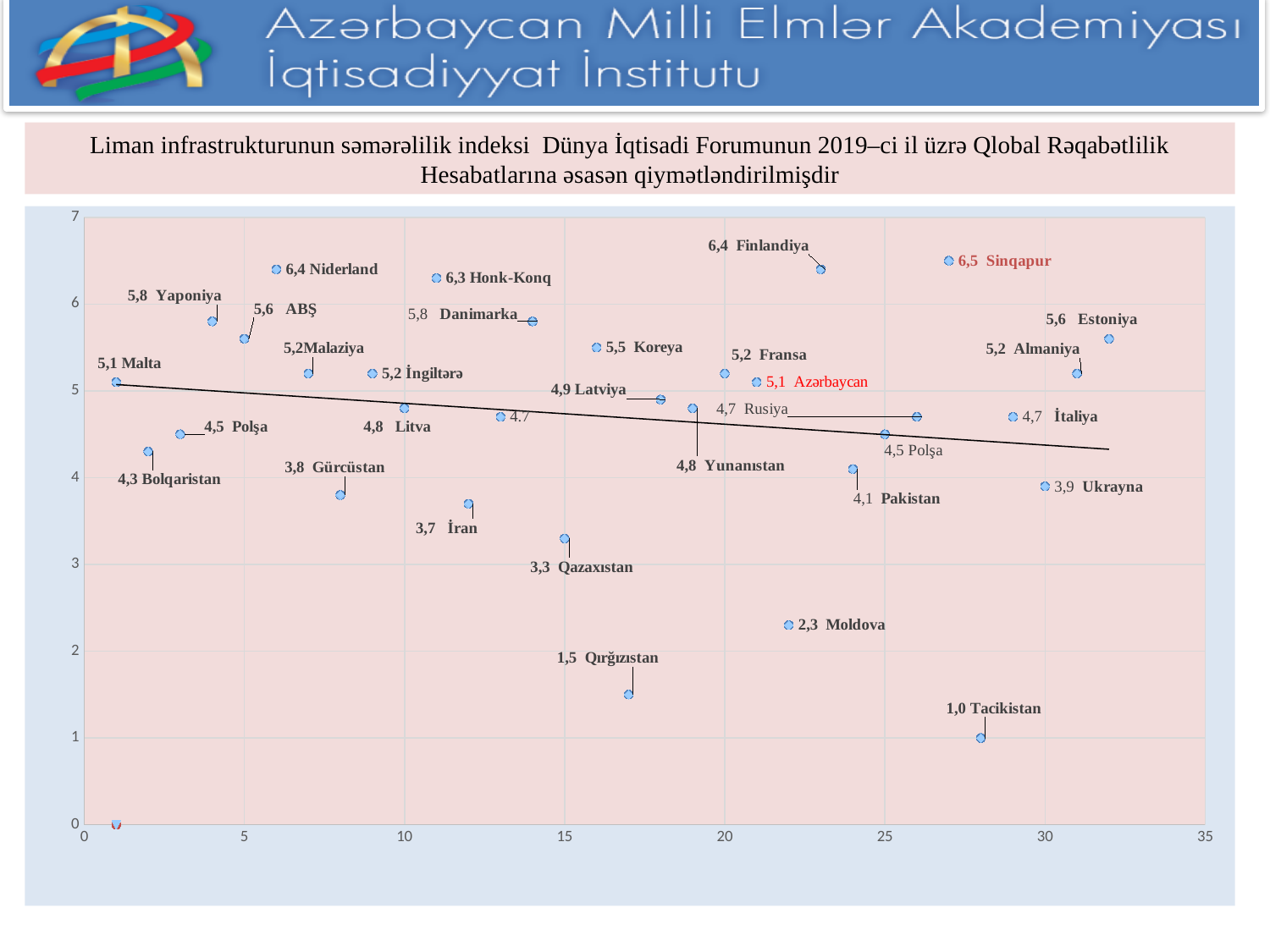
Which country has the highest index value on the chart? Sinqapur What is the index value shown for Moldova? 2,3 What type of chart is shown on the slide? scatter chart What is the port infrastructure efficiency index value for Azərbaycan? 5,1 Which labeled country has the lowest index value on the chart? Tacikistan Is the value for Finlandiya greater or less than 6? greater What is the index value shown for Tacikistan? 1,0 Which has a higher index value, Qazaxıstan or Moldova? Qazaxıstan Does the trend line on the chart rise or fall from left to right? fall What is the difference between the index values of Sinqapur and Azərbaycan? 1,4 Which country's label is shown in red on the chart? Sinqapur and Azərbaycan What is the index value shown for Sinqapur? 6,5